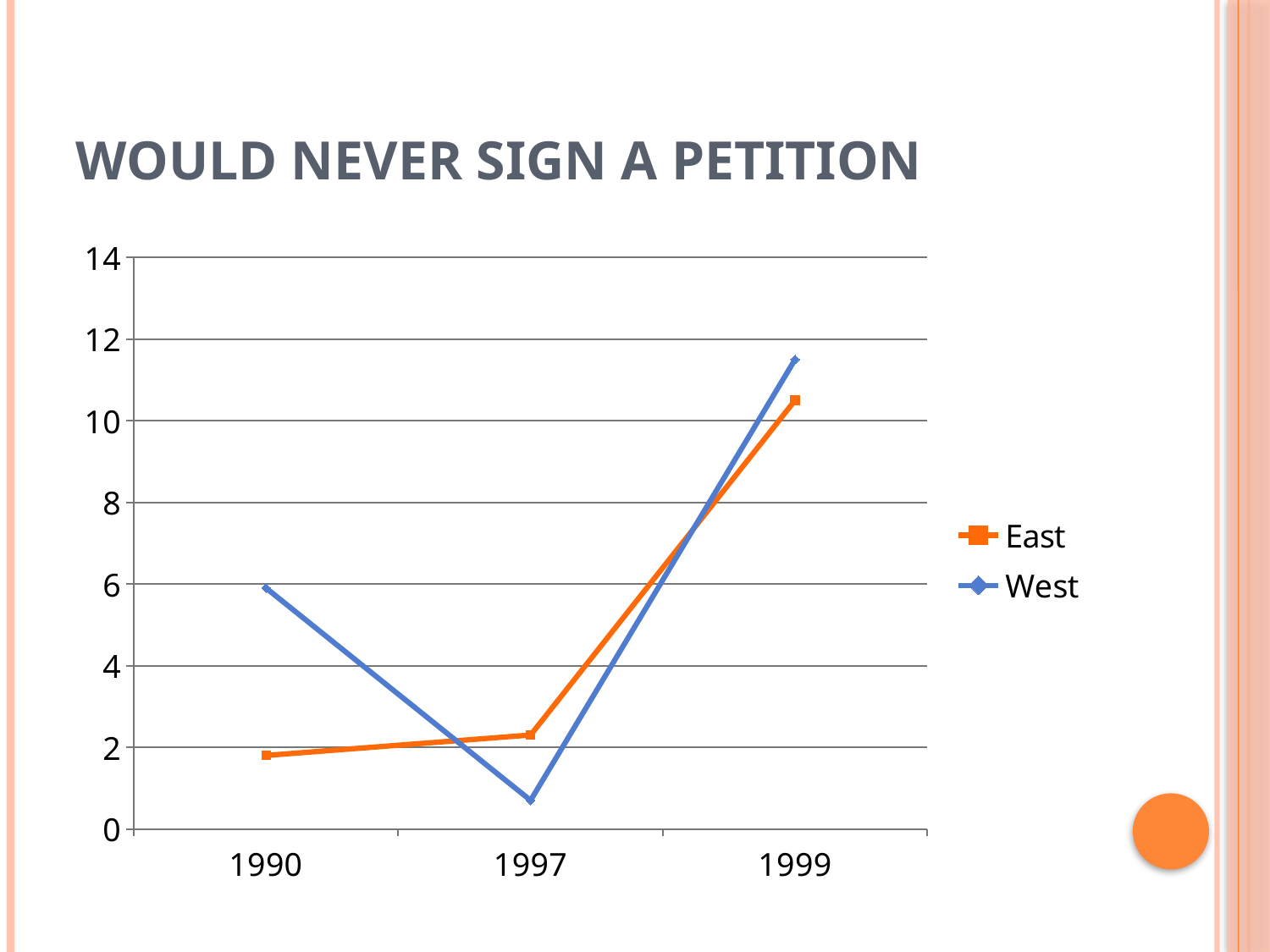
In which year is the East series at its highest? 1999 What kind of chart is shown on the slide? line chart Is the value for West in 1997 greater or less than 2? less In 1997, which series has the larger value, East or West? East Is the value for East in 1999 greater or less than 8? greater How many years are plotted along the x axis? 3 Does the East series rise or fall from 1990 to 1999? rise What is the title of the chart? Would Never Sign a Petition Is the value for West in 1990 greater or less than 4? greater How many series does the legend list? 2 In which year is the West series at its lowest? 1997 In 1990, which series has the larger value, East or West? West